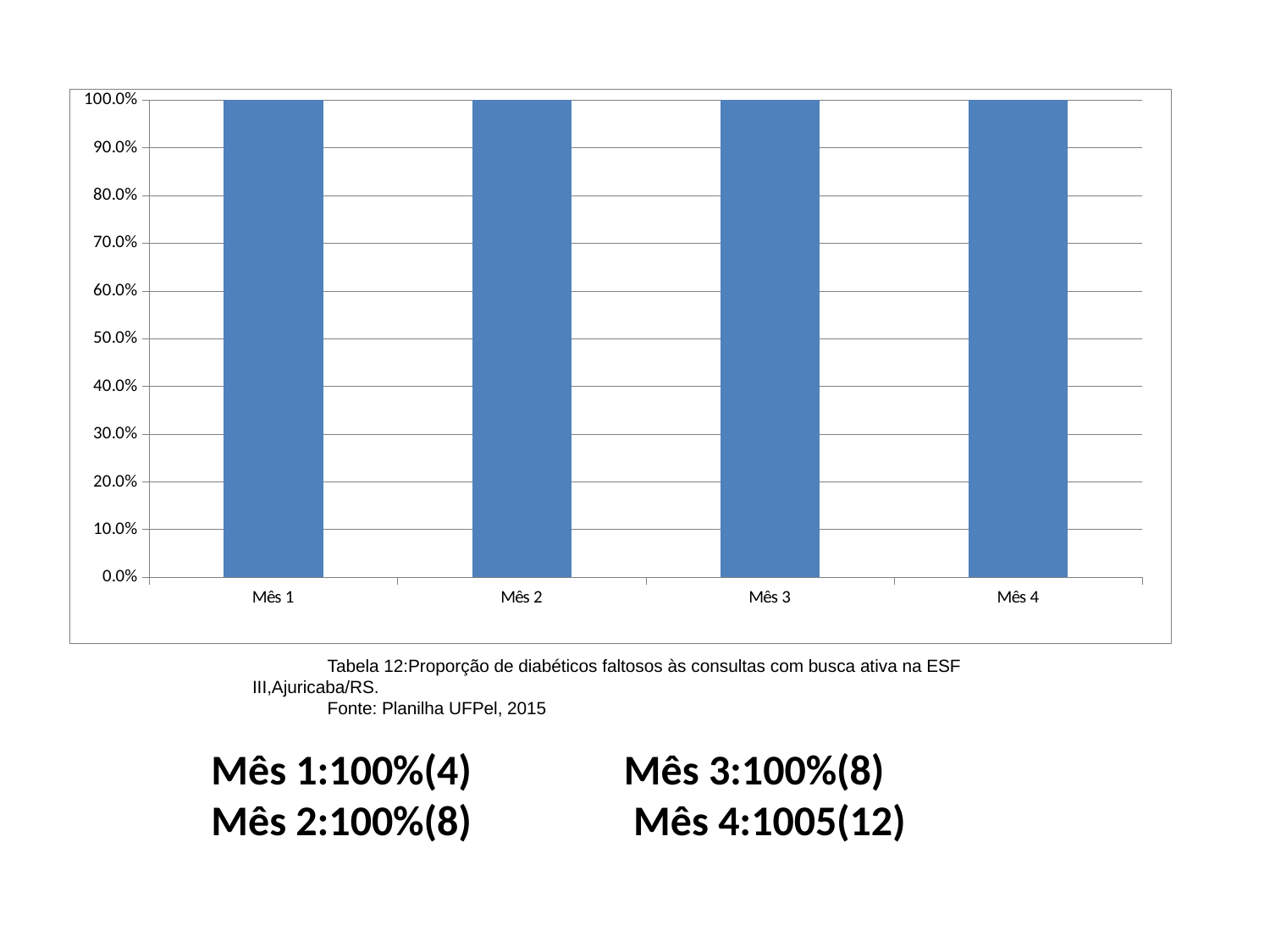
Is the value for Mês 4 greater or less than 50.0%? greater Do the values rise, fall or stay the same from Mês 1 to Mês 4? stay the same What is the value for Mês 1 in the chart? 100.0% What is the difference between the values for Mês 1 and Mês 2? 0.0% What kind of chart is shown on the slide? bar chart What source is cited below the chart? Planilha UFPel, 2015 What is the label of the first category on the x axis? Mês 1 What is the value for Mês 4 in the chart? 100.0% What is the value for Mês 3 in the chart? 100.0% Is the value for Mês 2 greater or less than 90.0%? greater How many categories are plotted on the x axis of the chart? 4